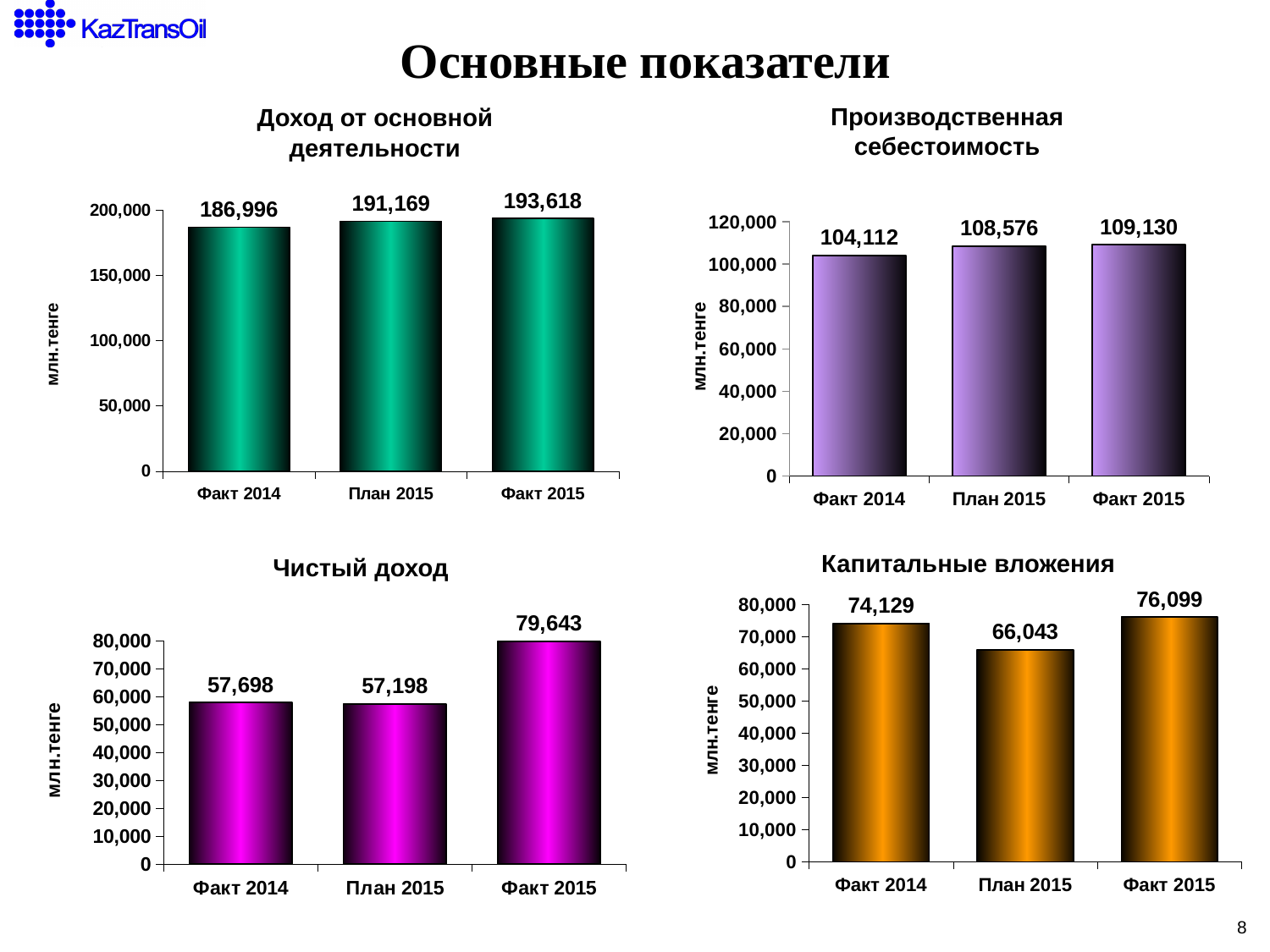
In the chart titled "Капитальные вложения", which category has the lowest value? План 2015 In the chart titled "Чистый доход", what is the value for Факт 2014? 57,698 How many categories are shown in the chart titled "Капитальные вложения"? 3 In the chart titled "Доход от основной деятельности", do the values rise or fall from Факт 2014 to Факт 2015? rise In the chart titled "Производственная себестоимость", is the value for Факт 2014 greater or less than 100,000? greater What kind of chart is the chart titled "Чистый доход"? bar chart In the chart titled "Чистый доход", which category has the highest value? Факт 2015 In the chart titled "Доход от основной деятельности", what is the value for Факт 2015? 193,618 In the chart titled "Капитальные вложения", which is larger: Факт 2014 or Факт 2015? Факт 2015 In the chart titled "Производственная себестоимость", what is the value for План 2015? 108,576 In the chart titled "Доход от основной деятельности", what is the difference between Факт 2015 and Факт 2014? 6,622 In the chart titled "Чистый доход", what is the difference between Факт 2015 and План 2015? 22,445